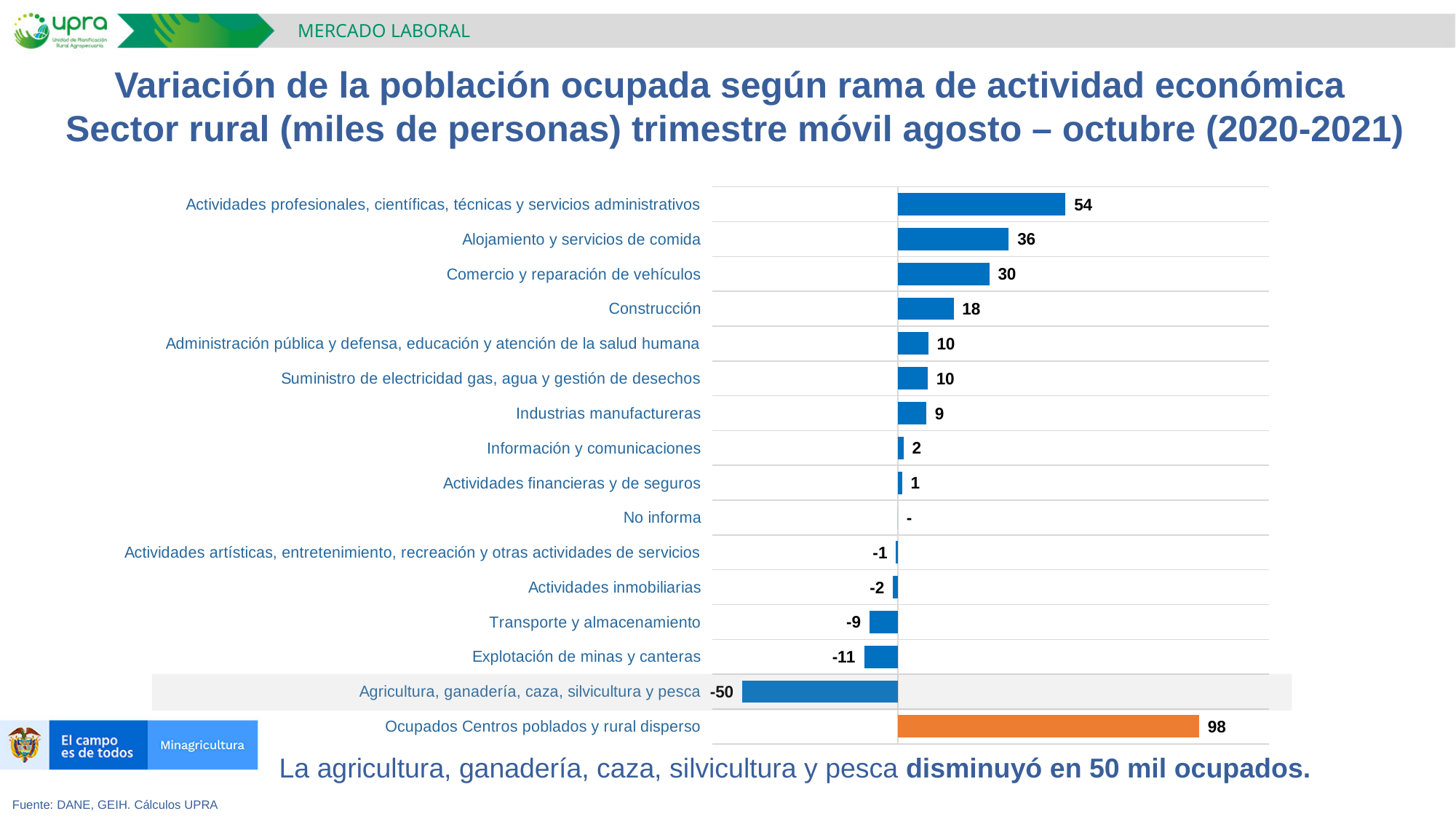
What is the value for Construcción? 18 What is the value for Agricultura, ganadería, caza, silvicultura y pesca? -50 Which bar is shown in orange rather than blue? Ocupados Centros poblados y rural disperso Which category has the highest value? Ocupados Centros poblados y rural disperso What kind of chart is shown on the slide? Bar chart What is the value for Explotación de minas y canteras? -11 Which is larger, the value for Comercio y reparación de vehículos or the value for Construcción? Comercio y reparación de vehículos What is the difference between the values for Transporte y almacenamiento and Explotación de minas y canteras? 2 What is the value for Ocupados Centros poblados y rural disperso? 98 How many categories are shown in the chart? 16 What is the difference between the values for Actividades profesionales, científicas, técnicas y servicios administrativos and Alojamiento y servicios de comida? 18 Which category has the lowest value? Agricultura, ganadería, caza, silvicultura y pesca